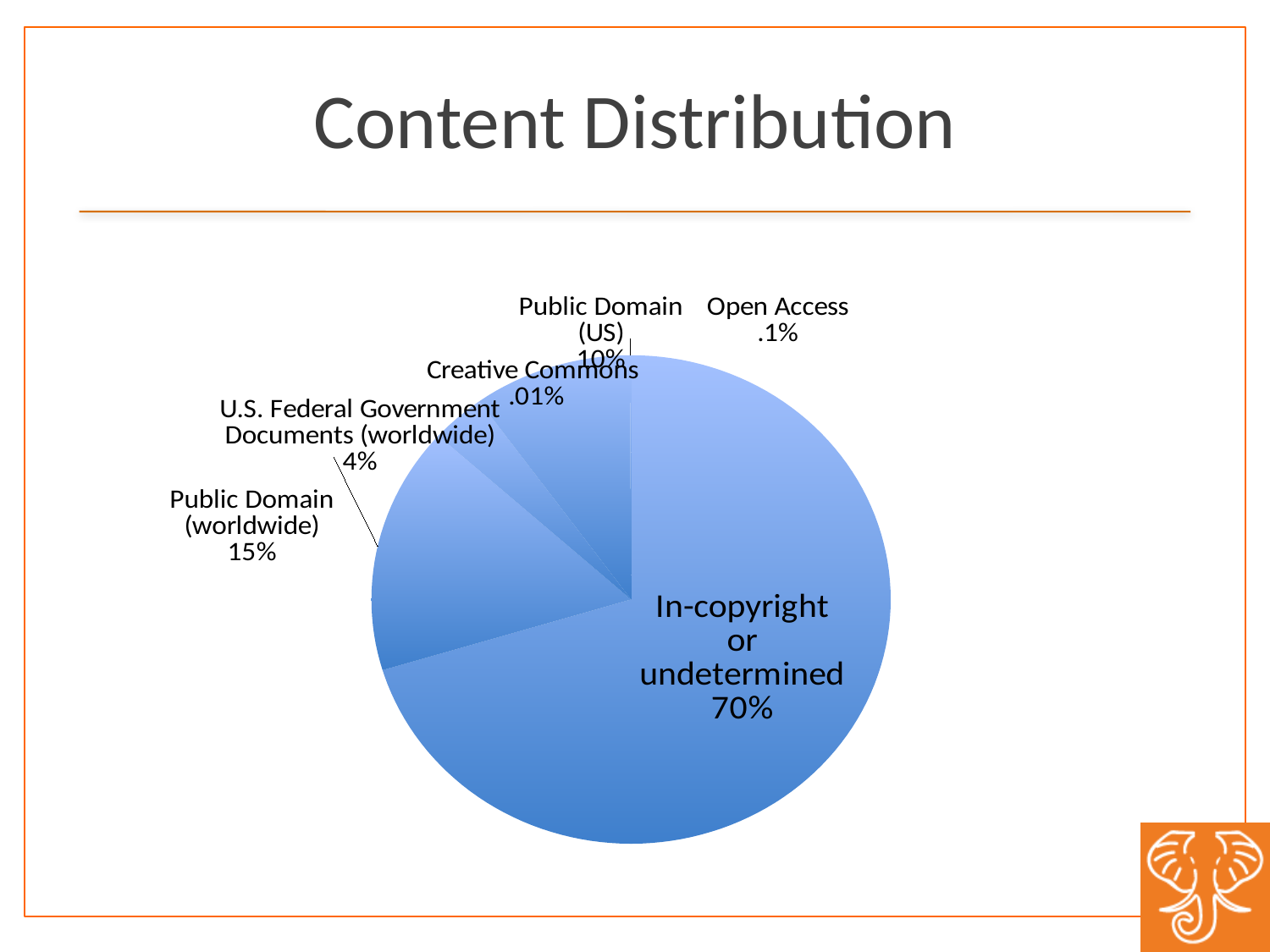
How many categories are shown in the pie chart? 6 What share of the pie is Creative Commons? .01% What kind of chart is shown on the slide? pie chart What share of the pie is Open Access? .1% What share of the pie is Public Domain (worldwide)? 15% Which is larger, Public Domain (worldwide) or U.S. Federal Government Documents (worldwide)? Public Domain (worldwide) Which category has the smallest slice of the pie? Creative Commons What is the title of the chart? Content Distribution Which category has the largest slice of the pie? In-copyright or undetermined What is the difference between the In-copyright or undetermined share and the Public Domain (worldwide) share? 55%